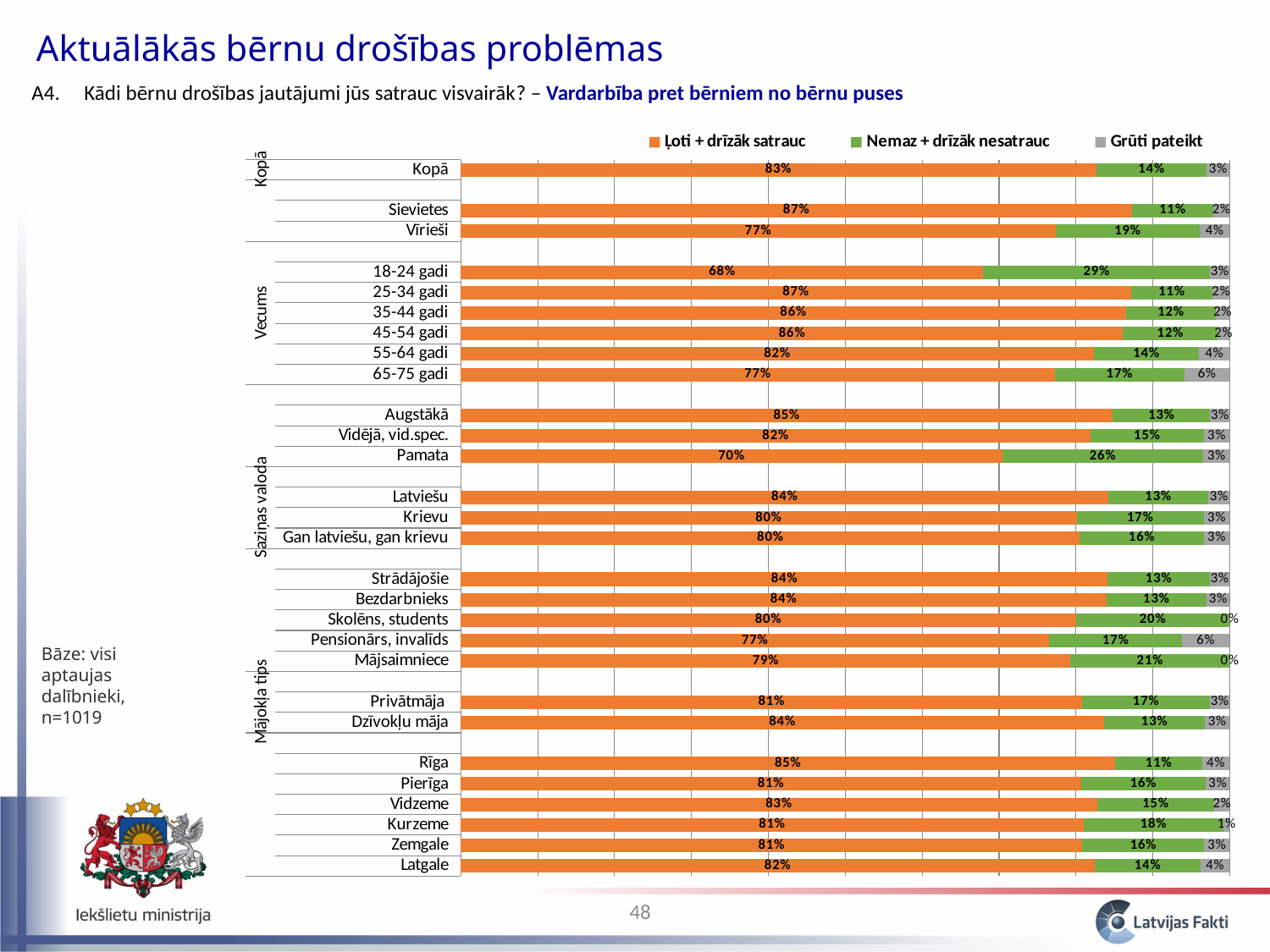
What kind of chart is shown on the slide? Stacked bar chart How many series does the legend list? 3 What is the difference between the "Ļoti + drīzāk satrauc" values for Sievietes and Vīrieši? 10 percentage points What is the value of "Nemaz + drīzāk nesatrauc" for 18-24 gadi? 29% Which category has the lowest value for "Ļoti + drīzāk satrauc"? 18-24 gadi What is the value of "Grūti pateikt" for 65-75 gadi? 6% What is the total of the stacked bar for Kopā? 100% Which has a larger "Ļoti + drīzāk satrauc" value, Rīga or Pierīga? Rīga What is the value of "Ļoti + drīzāk satrauc" for Kopā? 83% What is the value of "Ļoti + drīzāk satrauc" for Pamata? 70% Which category has the highest value for "Nemaz + drīzāk nesatrauc"? 18-24 gadi What is the value of "Grūti pateikt" for Skolēns, students? 0%